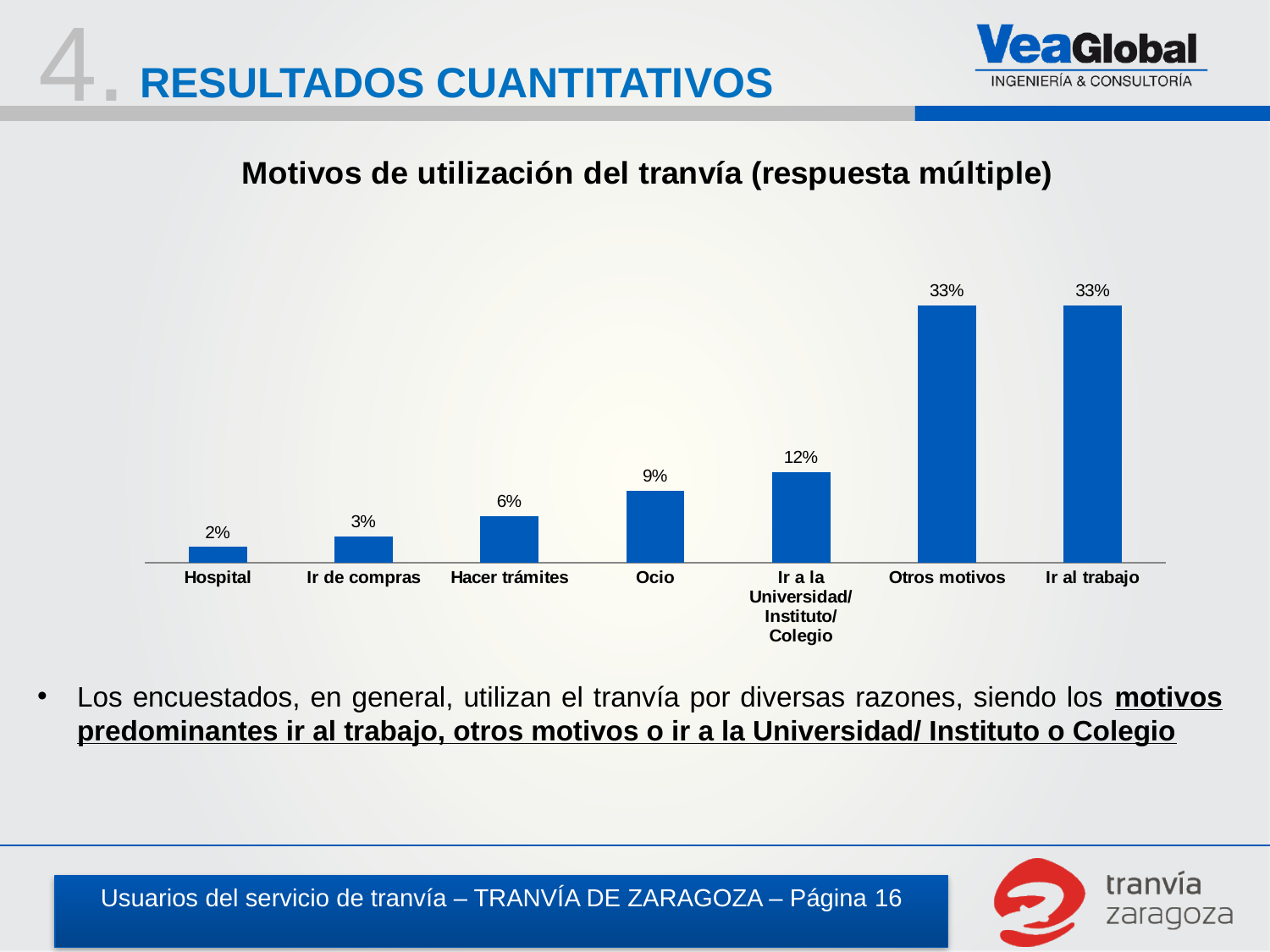
What kind of chart is shown on the slide? Bar chart What is the value for Ocio? 9% What is the value for Hacer trámites? 6% What is the value for Hospital? 2% What is the title of the chart? Motivos de utilización del tranvía (respuesta múltiple) What is the value for Ir a la Universidad/ Instituto/ Colegio? 12% What is the difference between the values for Ir a la Universidad/ Instituto/ Colegio and Ir de compras? 9% What is the difference between the values for Otros motivos and Ocio? 24% What is the value for Ir al trabajo? 33% Which is larger, the value for Ocio or the value for Hacer trámites? Ocio How many categories are shown in the chart? 7 Which category has the lowest value? Hospital